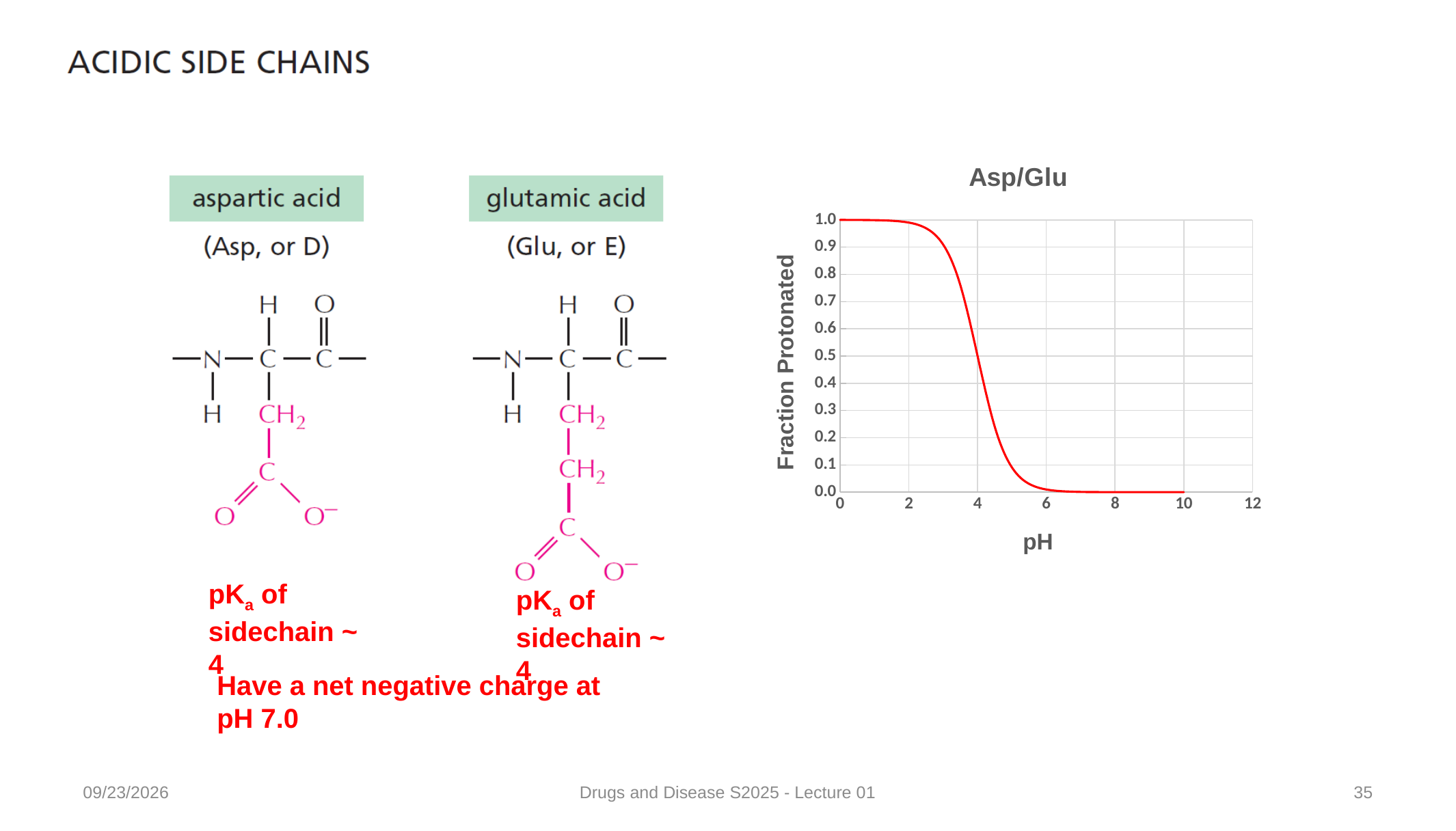
Is the fraction protonated at pH 1 greater or less than 0.5? greater How many lines are plotted on the chart? 1 Is the fraction protonated at pH 2 greater or less than 0.9? greater What is the title of the chart? Asp/Glu Is the fraction protonated at pH 6 greater or less than 0.1? less What is the label of the y axis of the chart? Fraction Protonated What kind of chart is shown on the slide? line chart What is the highest value shown on the x axis of the chart? 12 Which has a higher fraction protonated, pH 2 or pH 6? pH 2 As pH increases along the x axis, does the fraction protonated rise or fall? fall